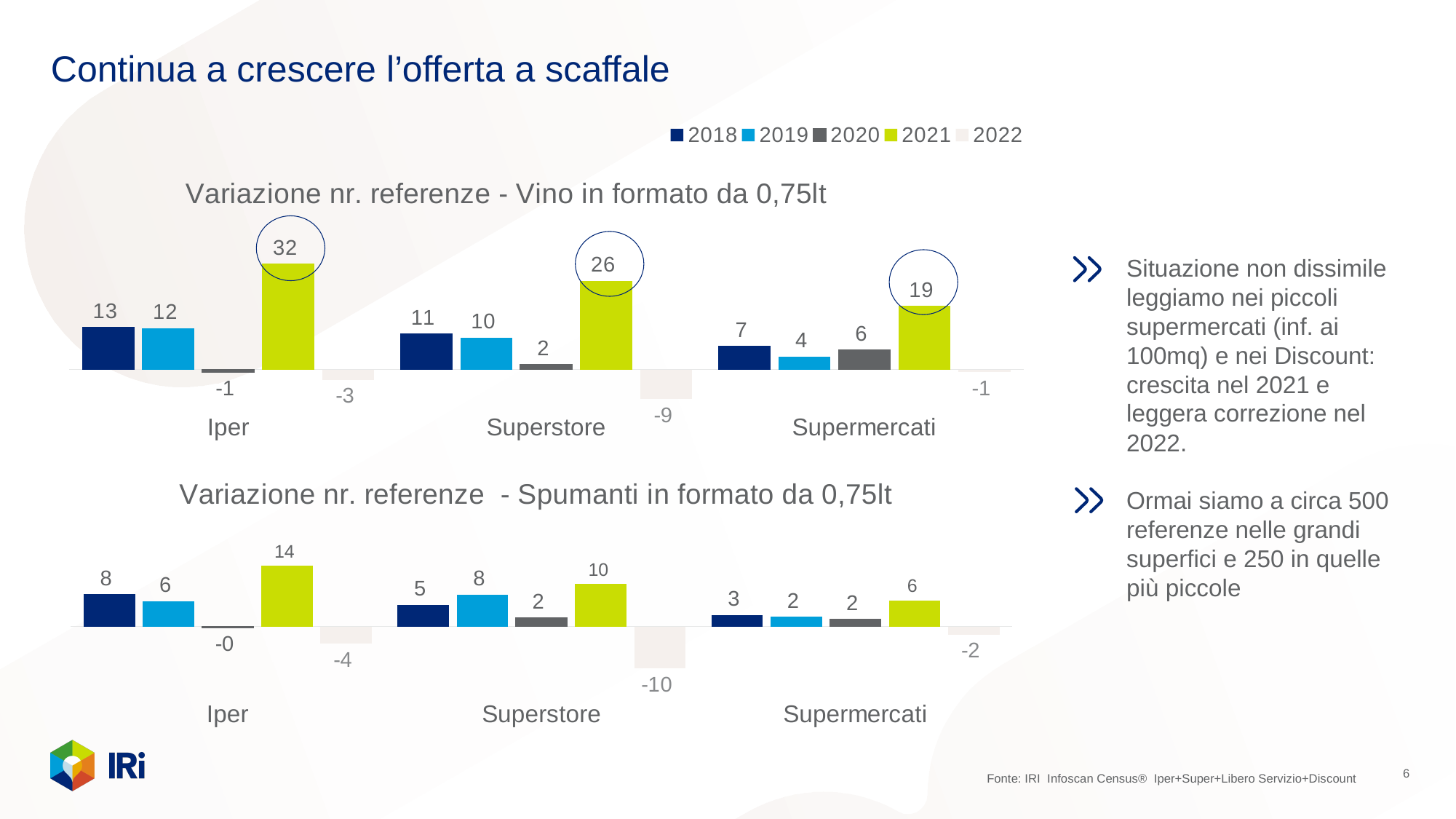
In the chart 'Variazione nr. referenze - Spumanti in formato da 0,75lt', what is the value for 2021 in Superstore? 10 In the chart 'Variazione nr. referenze - Vino in formato da 0,75lt', what is the difference between the 2021 values for Iper and Supermercati? 13 How many series does the legend list for the charts on the slide? 5 In the chart 'Variazione nr. referenze - Vino in formato da 0,75lt', which category has the lowest value for 2022? Superstore In the chart 'Variazione nr. referenze - Spumanti in formato da 0,75lt', what is the difference between the 2021 and 2022 values for Superstore? 20 How many categories are shown on the x axis of the chart 'Variazione nr. referenze - Spumanti in formato da 0,75lt'? 3 In the chart 'Variazione nr. referenze - Spumanti in formato da 0,75lt', which is larger for Superstore: the 2018 value or the 2019 value? 2019 In the chart 'Variazione nr. referenze - Vino in formato da 0,75lt', which category has the highest value for 2021? Iper In the chart 'Variazione nr. referenze - Vino in formato da 0,75lt', what is the value for 2021 in Iper? 32 In the chart 'Variazione nr. referenze - Vino in formato da 0,75lt', what is the value for 2022 in Superstore? -9 In the chart 'Variazione nr. referenze - Spumanti in formato da 0,75lt', what is the value for 2022 in Iper? -4 What kind of chart is 'Variazione nr. referenze - Vino in formato da 0,75lt'? Bar chart